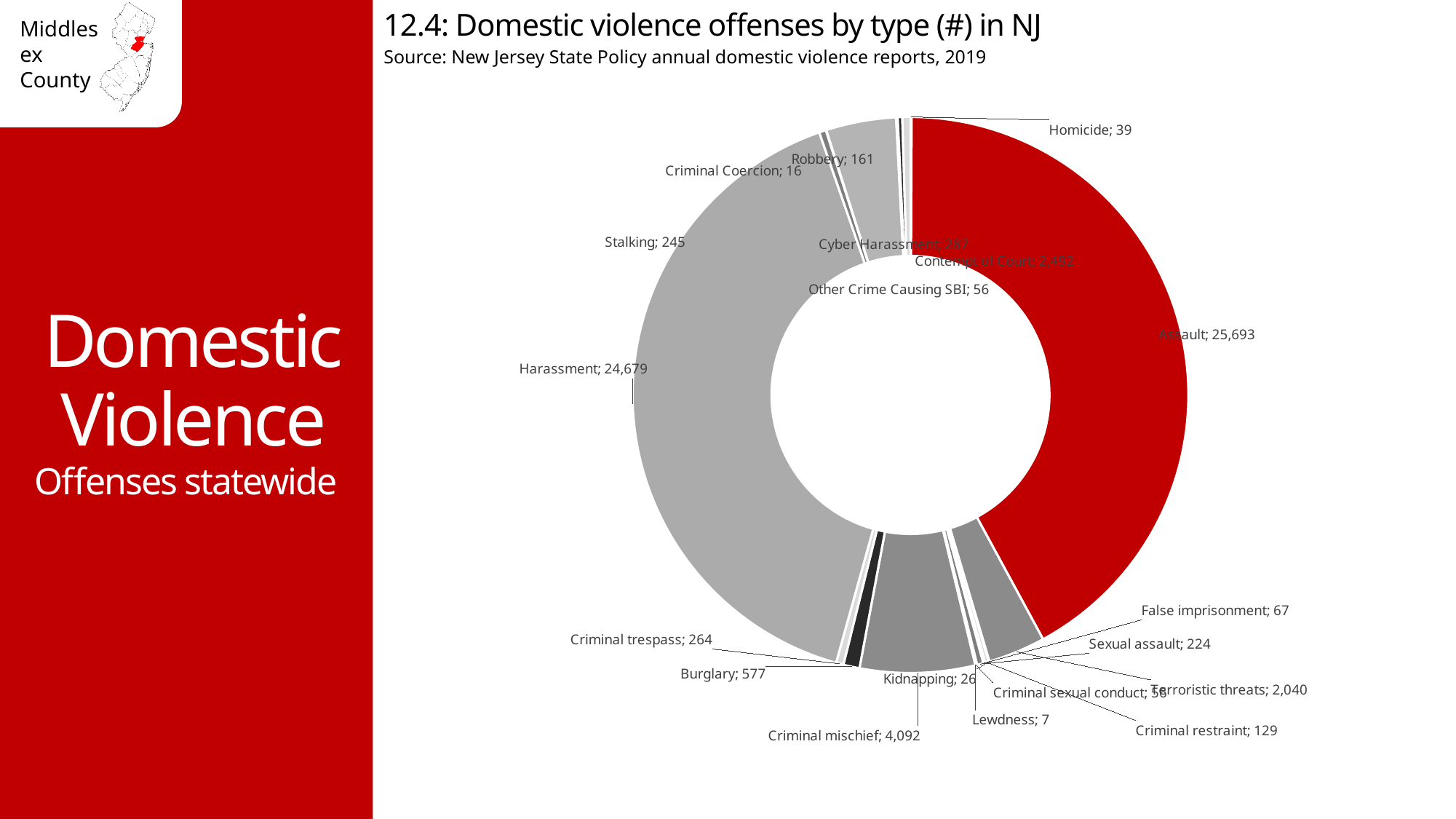
What is the value for Assault? 25,693 What is the value for Harassment? 24,679 Which is larger, Burglary or Criminal trespass? Burglary What is the value for Burglary? 577 Which offense type has the lowest value? Lewdness What is the value for Criminal mischief? 4,092 What is the title of the chart? 12.4: Domestic violence offenses by type (#) in NJ What is the difference between the values for Assault and Harassment? 1,014 What is the value for Terroristic threats? 2,040 What kind of chart is shown on the slide? doughnut chart What is the value for Homicide? 39 Which offense type has the highest value? Assault